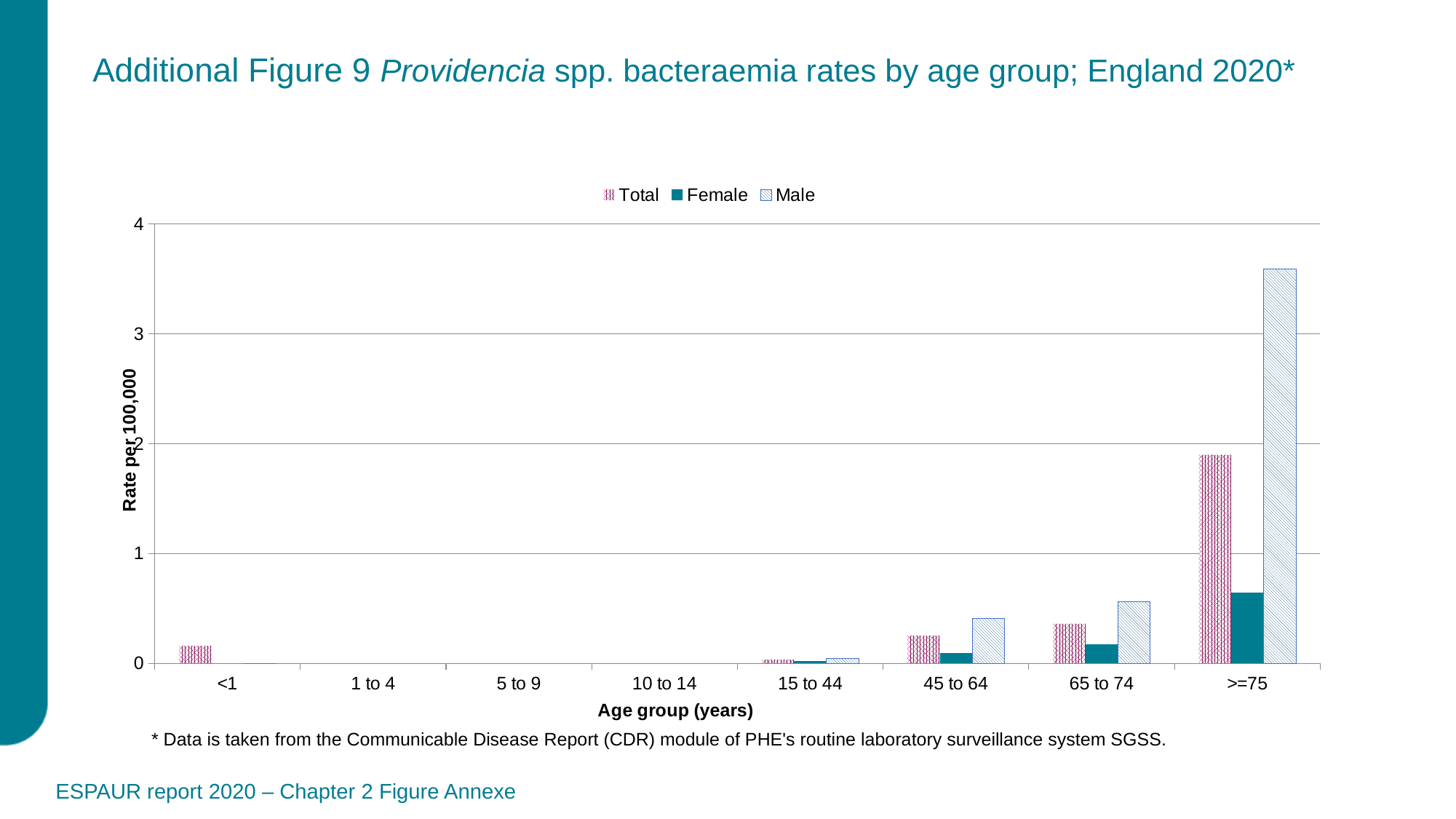
In the >=75 age group, which is larger, the Male rate or the Female rate? Male Which age group has the highest Total rate? >=75 What is the label of the y axis? Rate per 100,000 Do the rates generally rise or fall as age group increases from 15 to 44 to >=75? rise What kind of chart is shown on the slide? Bar chart Is the Female value for the >=75 age group greater or less than 1? less Is the Male value for the >=75 age group greater or less than 3? greater Which age group has the highest Male rate? >=75 How many series does the legend list? 3 How many age group categories are shown on the x axis? 8 Is the Total value for the >=75 age group greater or less than 2? less